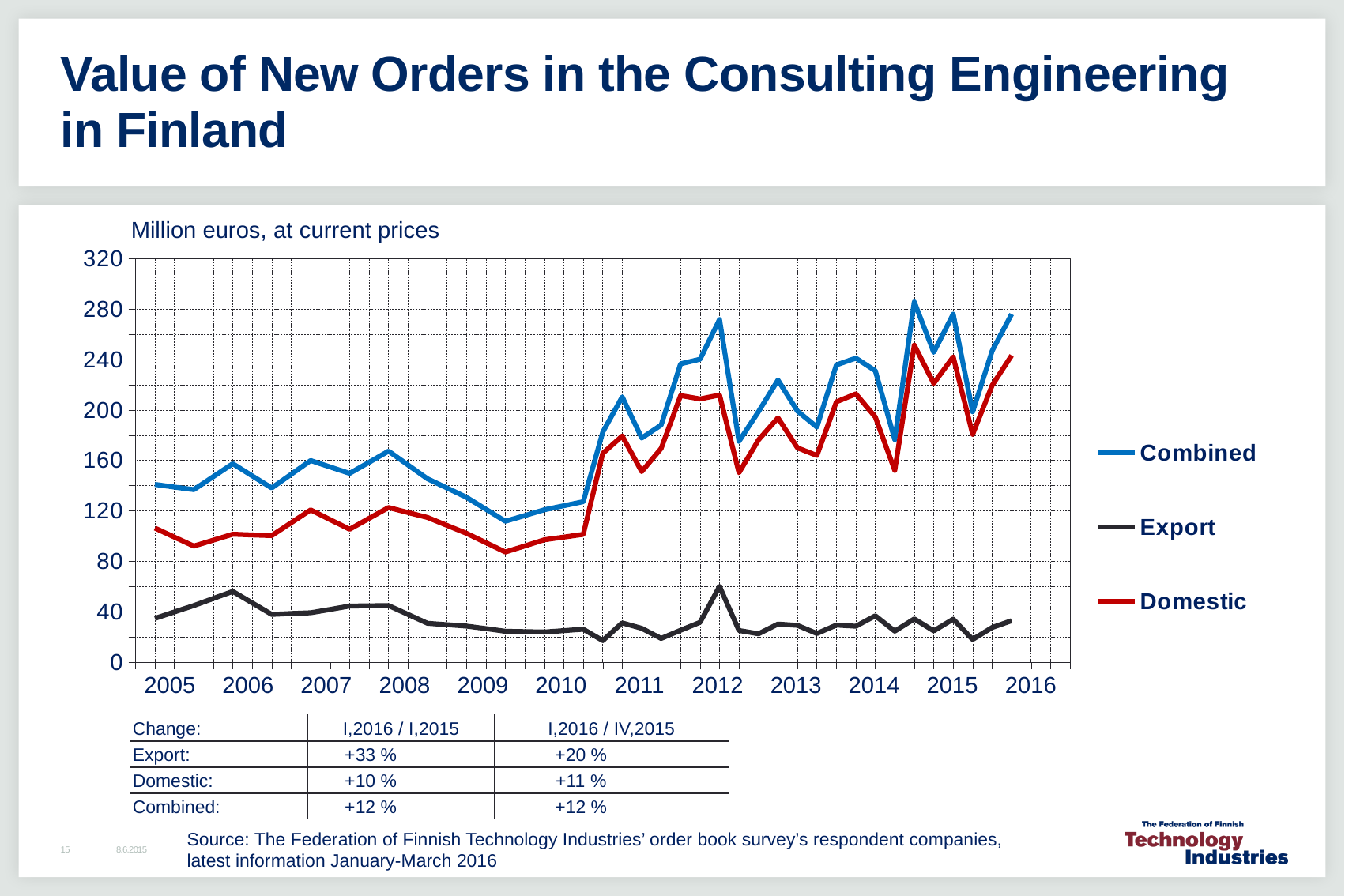
Is the highest Export value (in 2012) greater or less than 40? greater Is the Combined value at the start of 2005 greater or less than 120? greater Is the Export value at the start of 2005 greater or less than 80? less Which is larger at the start of 2005, the Combined value or the Domestic value? Combined How many series does the legend list? 3 What kind of chart is shown on the slide? line chart Overall, does the Combined series rise or fall from 2009 to 2016? rise Which series has the lowest values across the whole period? Export What are the series names listed in the legend? Combined, Export, Domestic What unit is stated above the chart for the values? Million euros, at current prices Which series reaches the highest value on the chart? Combined